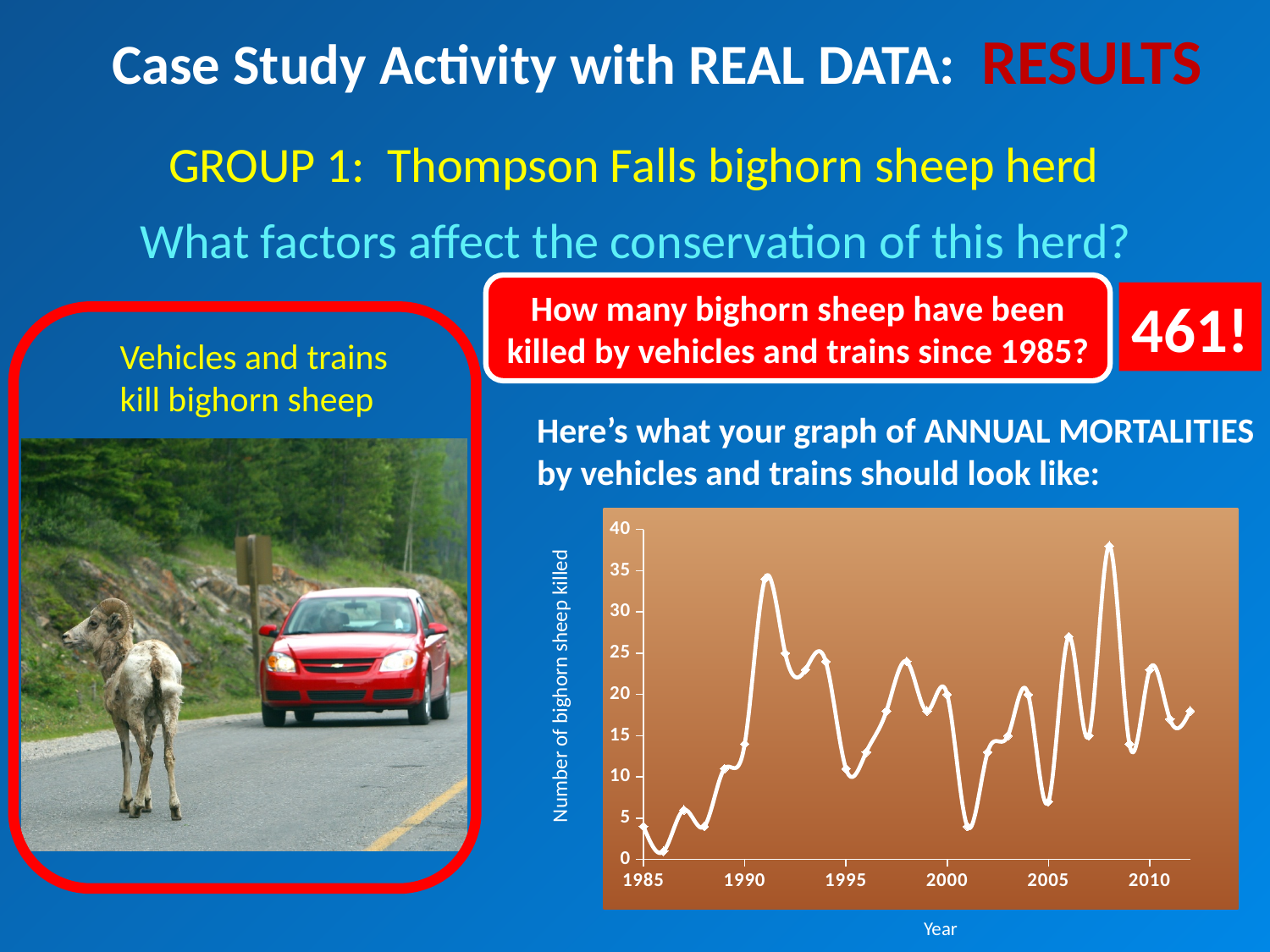
Which year had more bighorn sheep killed, 1991 or 2008? 2008 Is the number of bighorn sheep killed in 1991 greater or less than 30? greater Do the values rise or fall from 1985 to 1991? rise Which year had more bighorn sheep killed, 1986 or 1999? 1999 Is the number of bighorn sheep killed in 2006 greater or less than 20? greater What is the label on the y axis of the chart? Number of bighorn sheep killed Is the number of bighorn sheep killed in 1985 greater or less than 10? less What is the highest value shown on the y axis? 40 In which year was the number of bighorn sheep killed lowest? 1986 In which year was the number of bighorn sheep killed highest? 2008 What kind of chart is shown on the slide? line chart